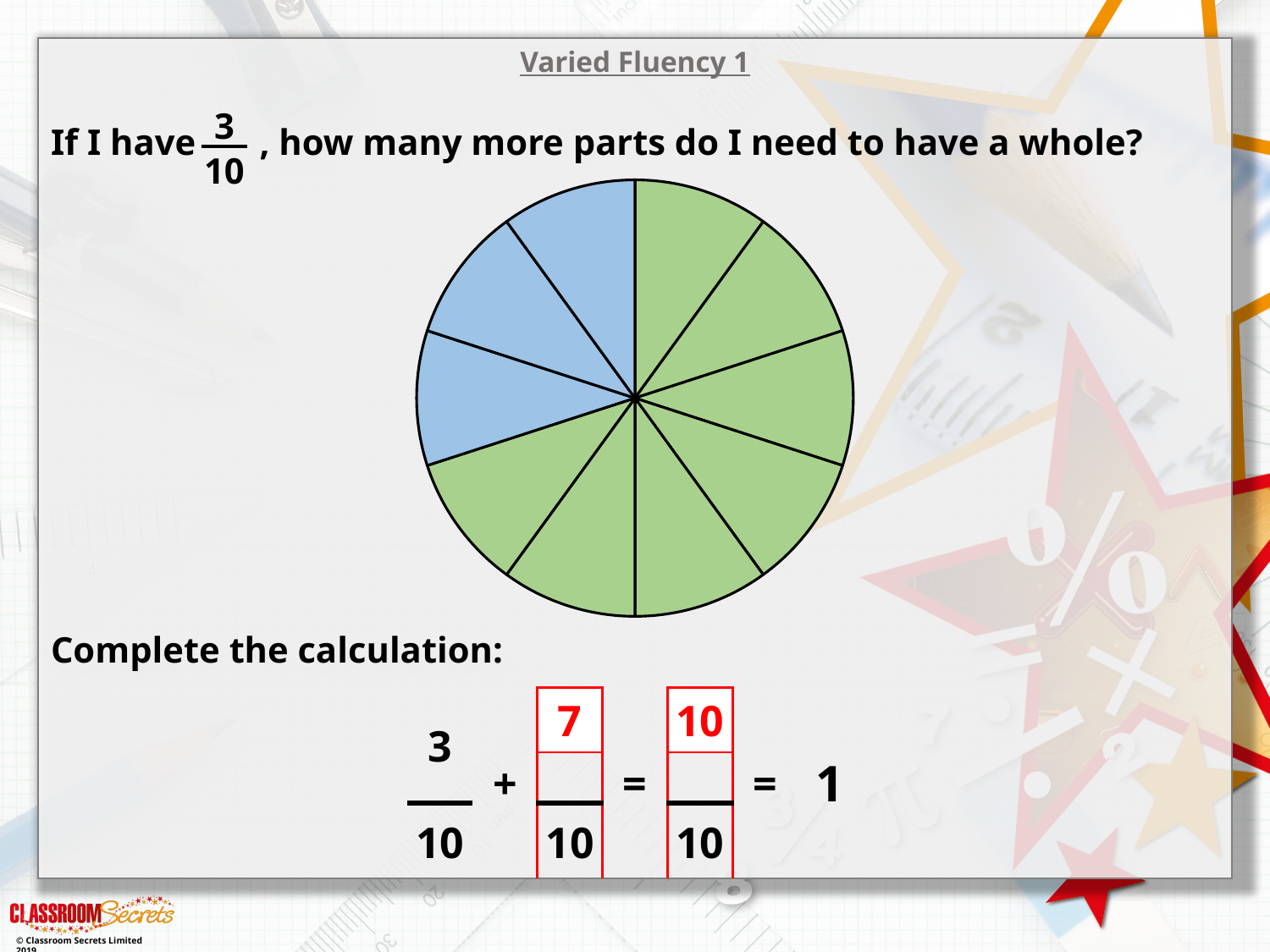
How many parts of the circle are shaded blue? 3 What kind of chart is shown on the slide? pie chart Which colour covers more of the circle, blue or green? green How many equal parts is the circle divided into? 10 How many parts of the circle are shaded green? 7 What is the total of 3/10 and 7/10 as shown in the calculation? 1 How many more green parts are there than blue parts? 4 According to the completed calculation, how many more parts are needed to make a whole from 3/10? 7 What fraction of the circle is shaded blue? 3/10 What fraction of the circle is shaded green? 7/10 What fraction is shown in the second red box of the calculation? 10/10 What is the title at the top of the slide? Varied Fluency 1